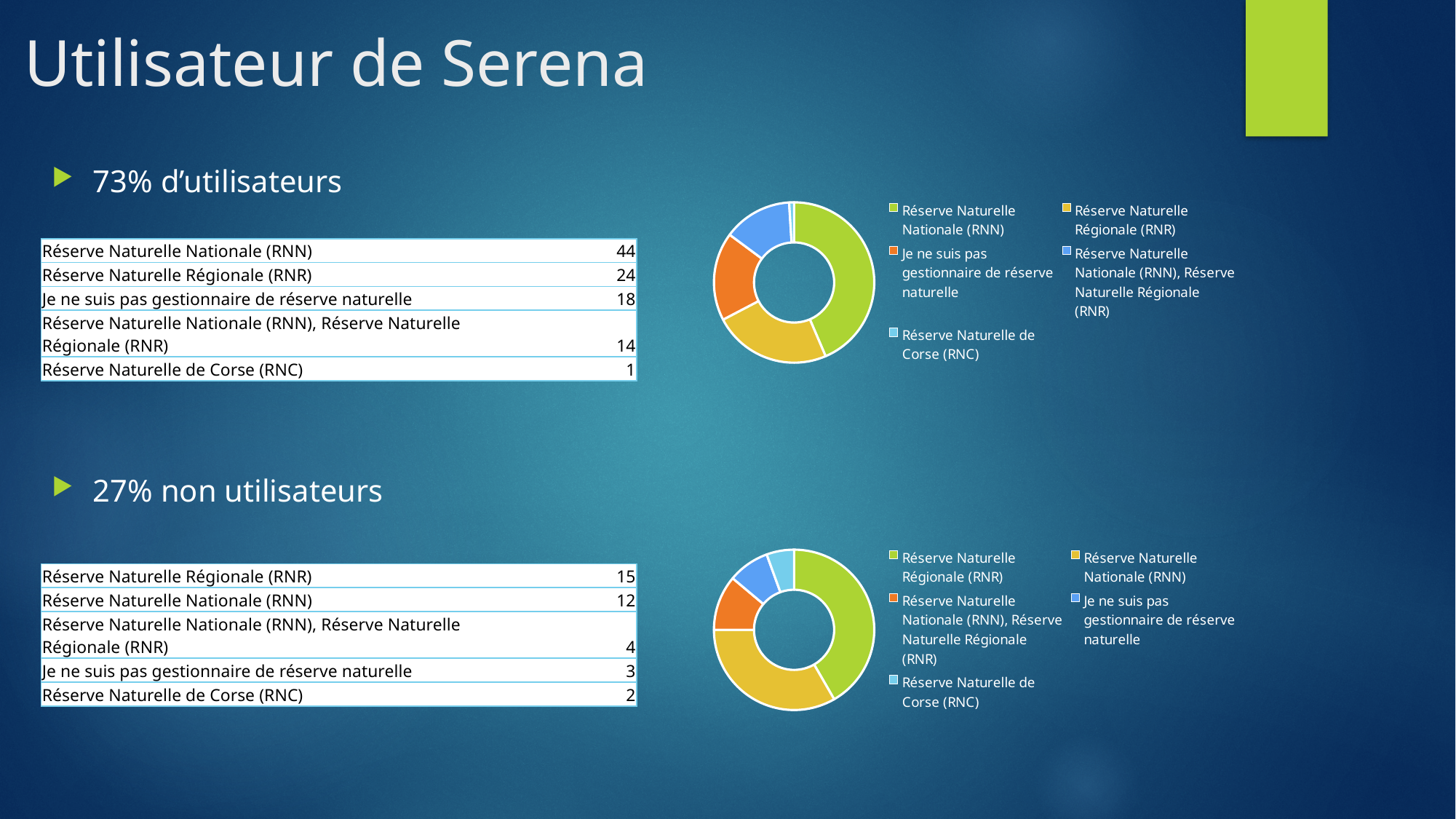
In the top chart (73% d'utilisateurs), what is the value for Réserve Naturelle Régionale (RNR)? 24 What type of chart is shown next to the '73% d'utilisateurs' table? Doughnut (pie) chart In the top chart (73% d'utilisateurs), which category has the smallest slice? Réserve Naturelle de Corse (RNC) How many legend entries does the bottom chart (27% non utilisateurs) list? 5 In the bottom chart (27% non utilisateurs), what is the difference between Réserve Naturelle Régionale (RNR) and Réserve Naturelle Nationale (RNN)? 3 In the bottom chart (27% non utilisateurs), which category has the largest slice? Réserve Naturelle Régionale (RNR) How many categories does the top chart (73% d'utilisateurs) show? 5 In the bottom chart (27% non utilisateurs), what is the value for Réserve Naturelle Nationale (RNN)? 12 In the bottom chart (27% non utilisateurs), which is larger: 'Je ne suis pas gestionnaire de réserve naturelle' or 'Réserve Naturelle de Corse (RNC)'? Je ne suis pas gestionnaire de réserve naturelle In the top chart (73% d'utilisateurs), which category has the largest slice? Réserve Naturelle Nationale (RNN) In the top chart (73% d'utilisateurs), what colour is the slice for 'Je ne suis pas gestionnaire de réserve naturelle'? Orange In the top chart (73% d'utilisateurs), what is the difference between Réserve Naturelle Nationale (RNN) and Réserve Naturelle Régionale (RNR)? 20